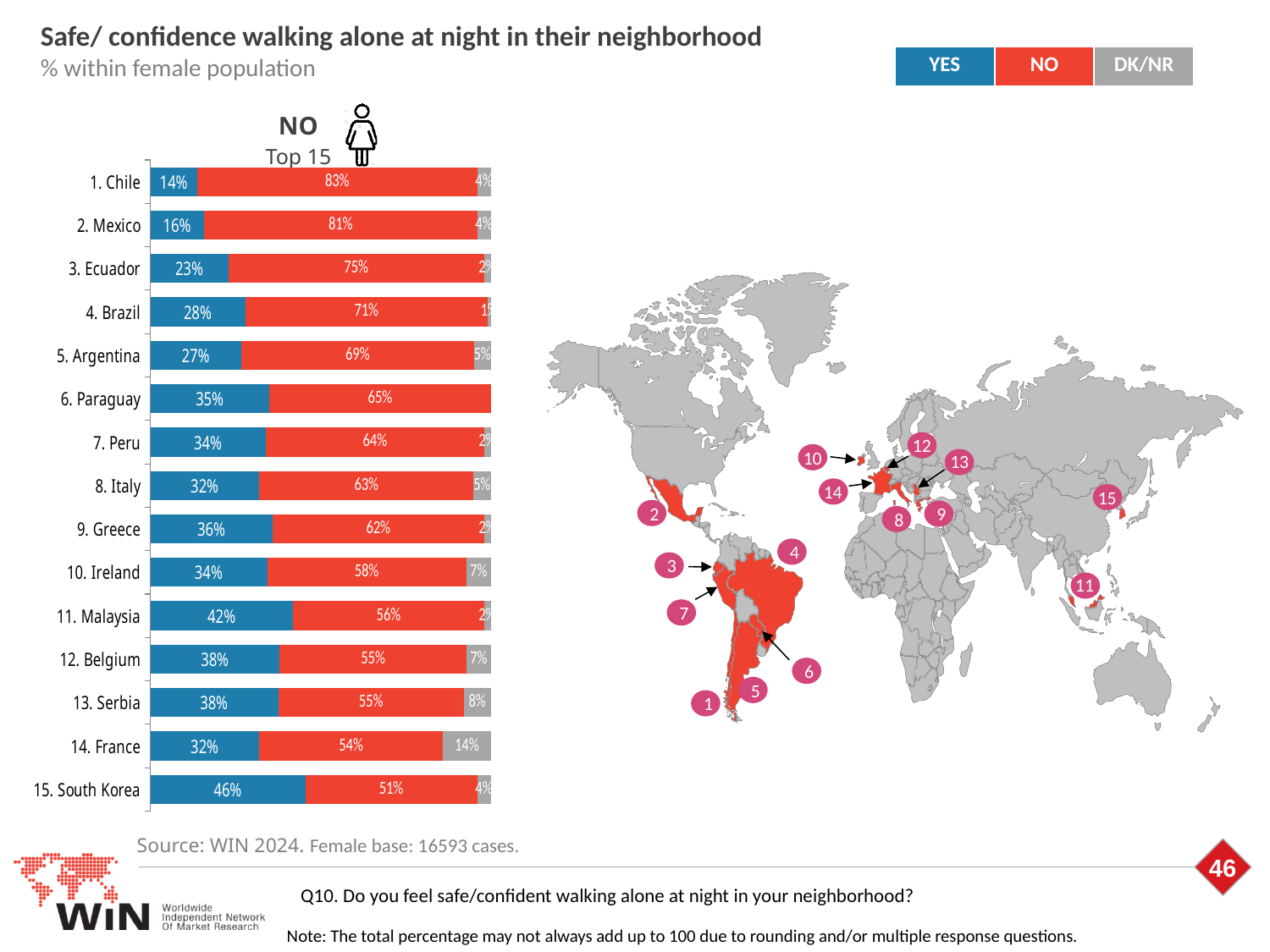
How many series does the legend list? 3 What is the YES value for South Korea? 46% Which has a higher YES percentage, Malaysia or Belgium? Malaysia What kind of chart is used to show the Top 15 countries? Stacked bar chart Which country has the highest NO percentage in the chart? Chile What is the DK/NR value for France? 14% Which colour represents the NO responses in the chart? Red What is the difference between the NO percentages for Mexico and Brazil? 10% What is the total of the YES, NO and DK/NR values for Serbia? 101% Which country has the lowest YES percentage in the chart? Chile What percentage of women in Chile answered NO to feeling safe walking alone at night? 83% How many countries are shown in the bar chart? 15